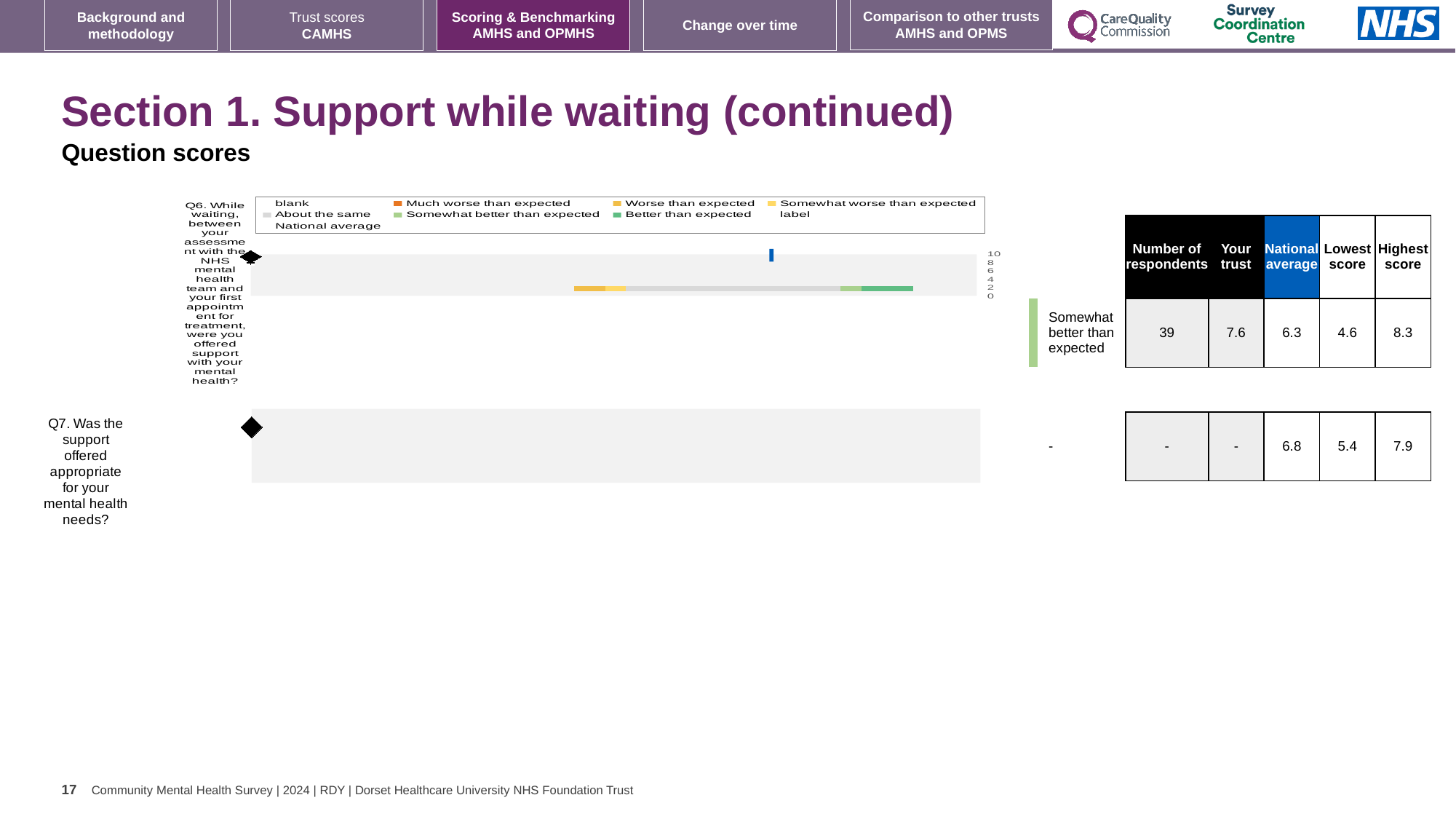
What kind of chart is shown on the slide? bar chart How many entries does the chart legend list? 9 What is the 'Your trust' score for Q6? 7.6 What is the national average score for Q7? 6.8 What colour does the legend use for 'Better than expected'? green For Q6, which is larger: the 'Your trust' score or the national average? Your trust How many questions (categories) are plotted in the chart? 2 What is the highest tick value shown on the chart's score axis? 10 What is the difference between the highest score and the lowest score for Q6? 3.7 What is the number of respondents for Q6? 39 What is the national average score for Q6? 6.3 Which benchmark category is the trust's Q6 score placed in? Somewhat better than expected